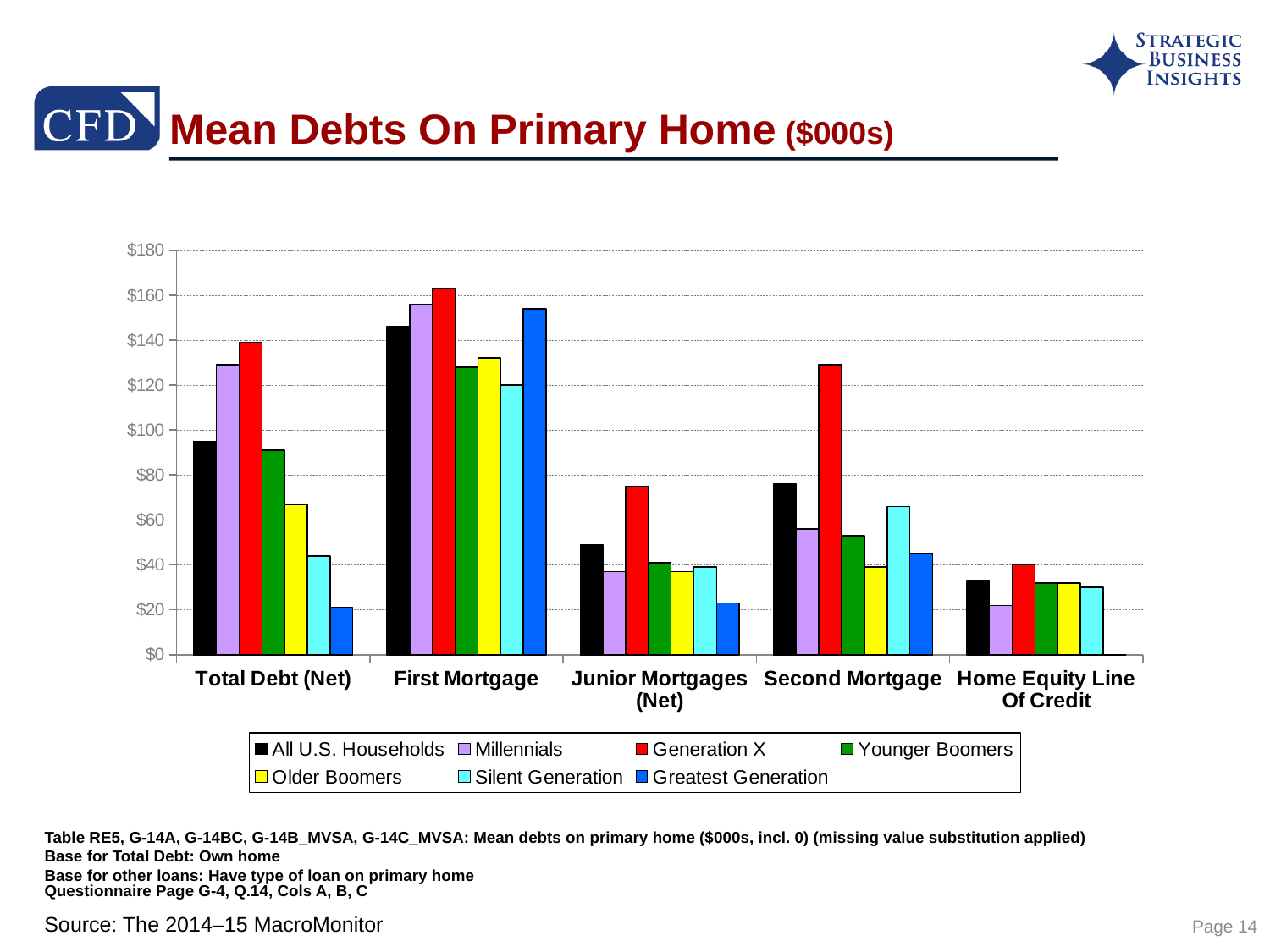
How many series does the legend list? 7 Is the value for Greatest Generation in Total Debt (Net) greater or less than $40? less What kind of chart is shown on the slide? bar chart Is the value for Millennials in Total Debt (Net) greater or less than $120? greater What is the title of the chart? Mean Debts On Primary Home ($000s) For Second Mortgage, which is larger: Generation X or All U.S. Households? Generation X Is the value for Generation X in Second Mortgage greater or less than $100? greater How many debt categories are shown along the x axis? 5 Which series has the highest value for Total Debt (Net)? Generation X Which series has the highest value for First Mortgage? Generation X For First Mortgage, which is larger: Greatest Generation or Silent Generation? Greatest Generation Which series has the lowest value for Total Debt (Net)? Greatest Generation